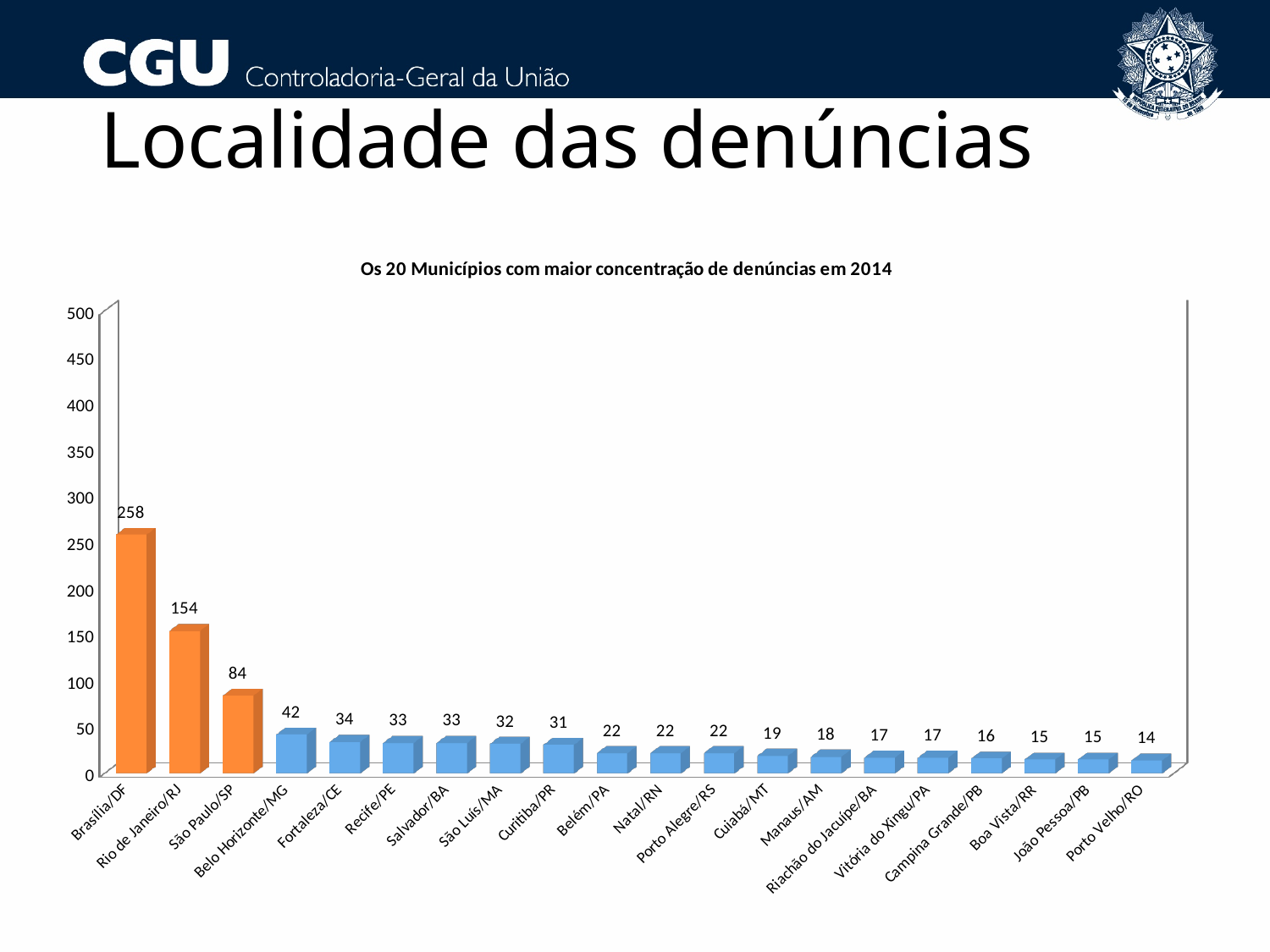
What is the value for Brasília/DF? 258 What is the value for Belo Horizonte/MG? 42 What is the title of the chart? Os 20 Municípios com maior concentração de denúncias em 2014 Is the value for Rio de Janeiro/RJ greater or less than 150? greater What kind of chart is shown on the slide? Bar chart What is the difference between the values for Brasília/DF and Rio de Janeiro/RJ? 104 Which is larger, the value for Fortaleza/CE or the value for Curitiba/PR? Fortaleza/CE How many municipalities are shown on the chart? 20 What is the value for Porto Velho/RO? 14 What is the difference between the values for São Paulo/SP and Belo Horizonte/MG? 42 Which municipality has the lowest number of denúncias? Porto Velho/RO Which municipality has the highest number of denúncias? Brasília/DF